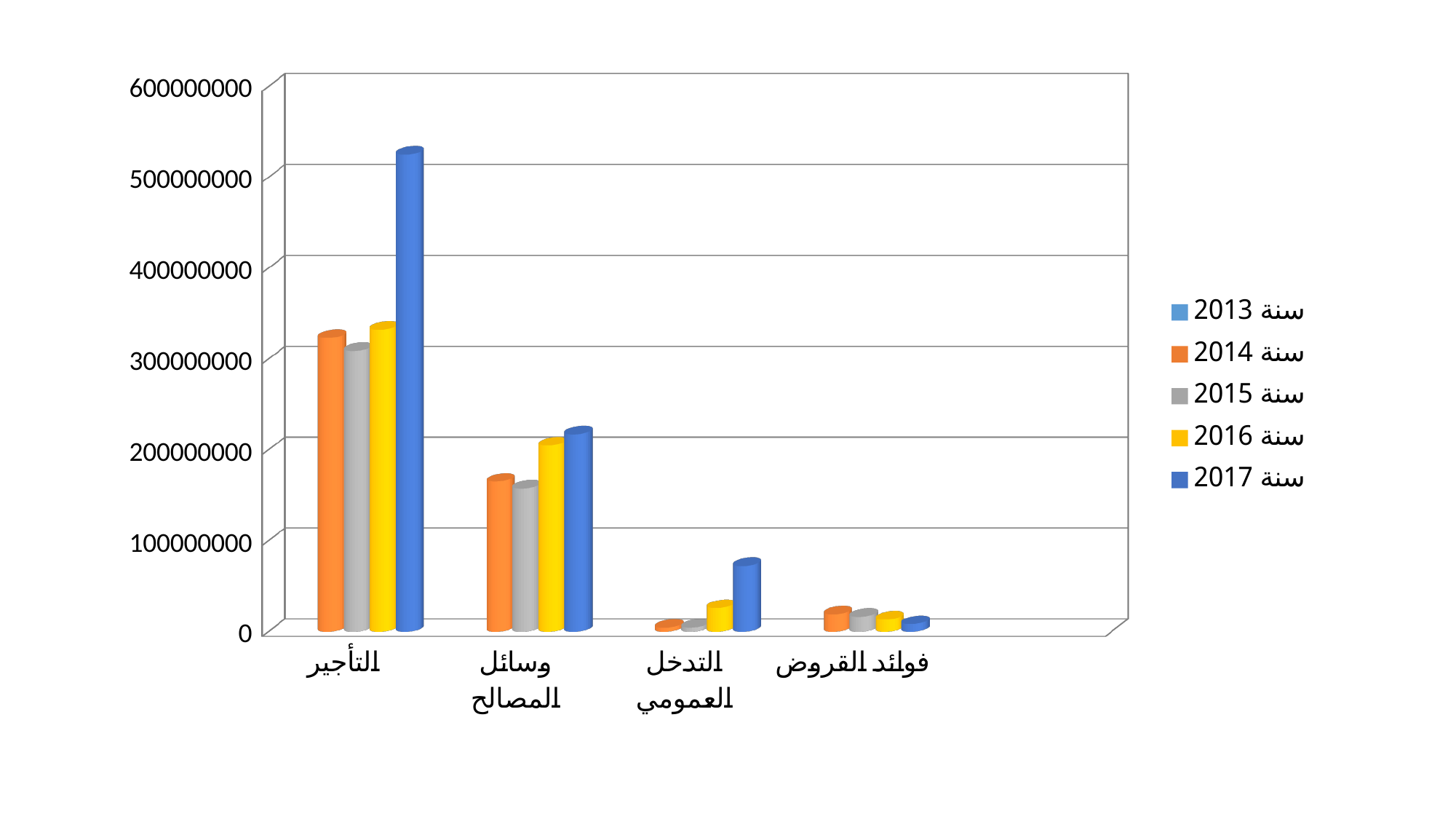
For فوائد القروض, which is larger: the value for سنة 2014 or سنة 2017? سنة 2014 Is the value for التأجير in سنة 2017 greater or less than 500000000? greater Which category has the highest value for سنة 2017? التأجير Which category has the lowest value for سنة 2017? فوائد القروض Is the value for وسائل المصالح in سنة 2014 greater or less than 200000000? less For التأجير, which is larger: the value for سنة 2016 or سنة 2017? سنة 2017 Is the value for التدخل العمومي in سنة 2017 greater or less than 100000000? less How many categories are shown on the x axis? 4 Which legend entry is listed first? سنة 2013 What kind of chart is shown on the slide? bar chart How many series does the legend list? 5 For التدخل العمومي, do the values rise or fall from سنة 2014 to سنة 2017? rise